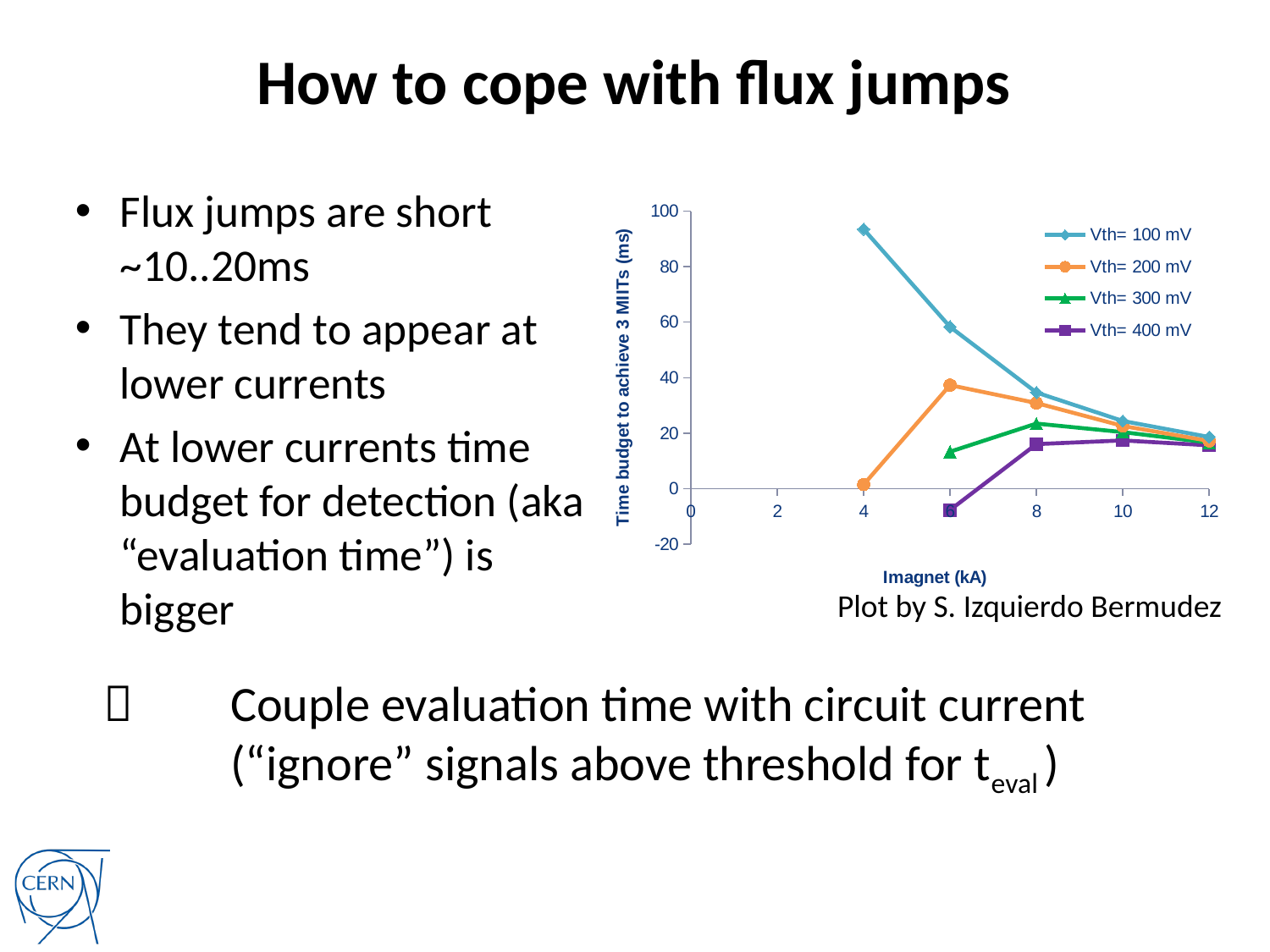
What is the title of the chart's y axis? Time budget to achieve 3 MIITs (ms) Does the Vth= 100 mV series rise or fall as the magnet current increases? fall What is the title of the chart's x axis? Imagnet (kA) Is the value for Vth= 400 mV at 6 kA greater or less than 0? less What kind of chart is shown on the slide? line chart At 4 kA, which series has the highest value? Vth= 100 mV How many series does the chart's legend list? 4 Is the value for Vth= 100 mV at 4 kA greater or less than 80? greater Is the value for Vth= 200 mV at 6 kA greater or less than 20? greater At 6 kA, which series has the larger value, Vth= 100 mV or Vth= 200 mV? Vth= 100 mV At 8 kA, which series has the larger value, Vth= 300 mV or Vth= 400 mV? Vth= 300 mV